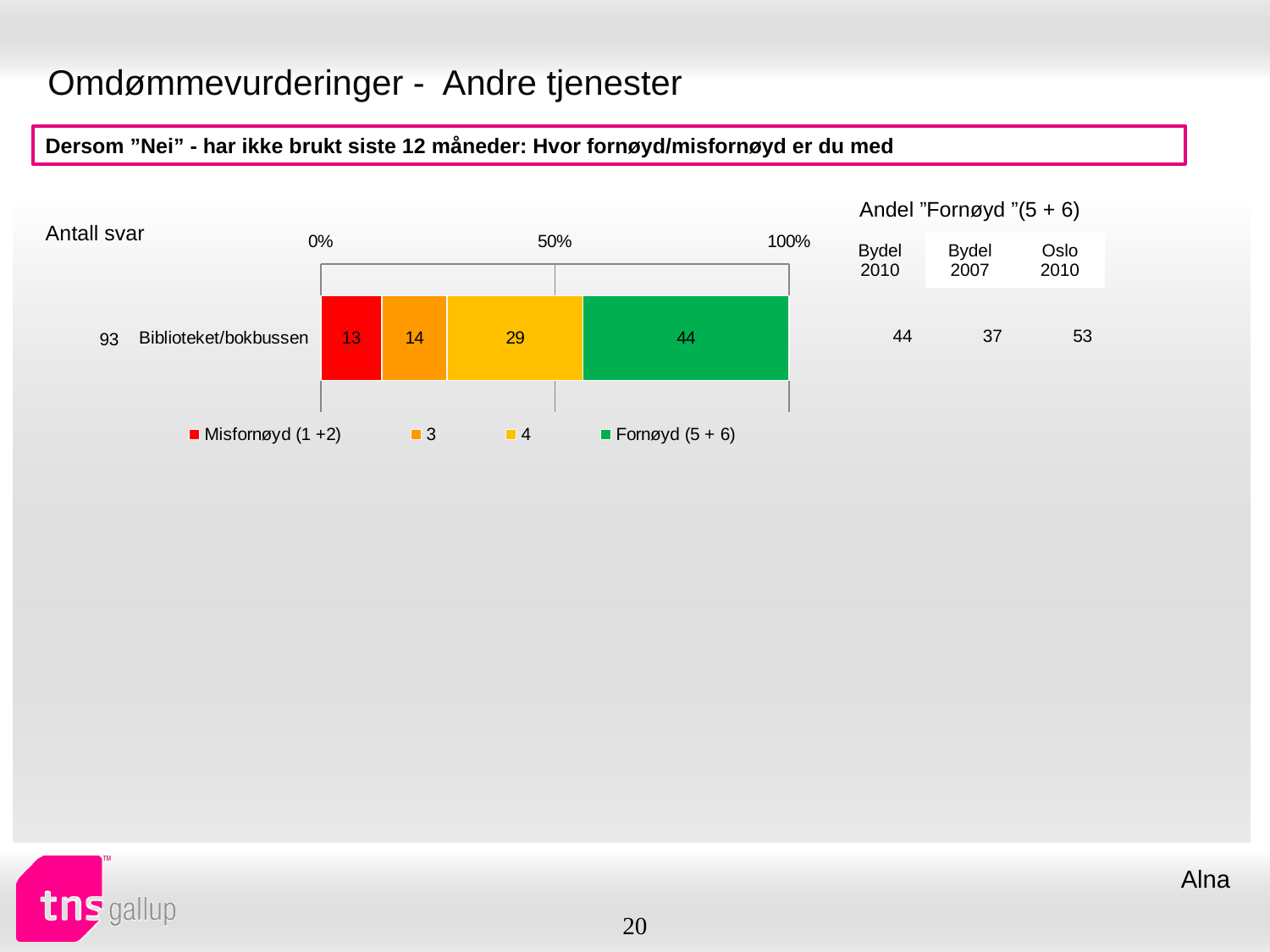
Which segment of the Biblioteket/bokbussen bar has the largest value? Fornøyd (5 + 6) Which segment of the Biblioteket/bokbussen bar has the smallest value? Misfornøyd (1 +2) How many categories are plotted in the chart? 1 What is the value of the 'Fornøyd (5 + 6)' segment for Biblioteket/bokbussen? 44 Which is larger for Biblioteket/bokbussen, the '4' segment or the '3' segment? 4 What is the value of the 'Misfornøyd (1 +2)' segment for Biblioteket/bokbussen? 13 What is the value of the '4' segment for Biblioteket/bokbussen? 29 How many series does the legend list? 4 What is the total of the stacked bar for Biblioteket/bokbussen? 100 What type of chart is shown on the slide? bar chart What is the value of the '3' segment for Biblioteket/bokbussen? 14 What is the difference between the 'Fornøyd (5 + 6)' and 'Misfornøyd (1 +2)' values for Biblioteket/bokbussen? 31